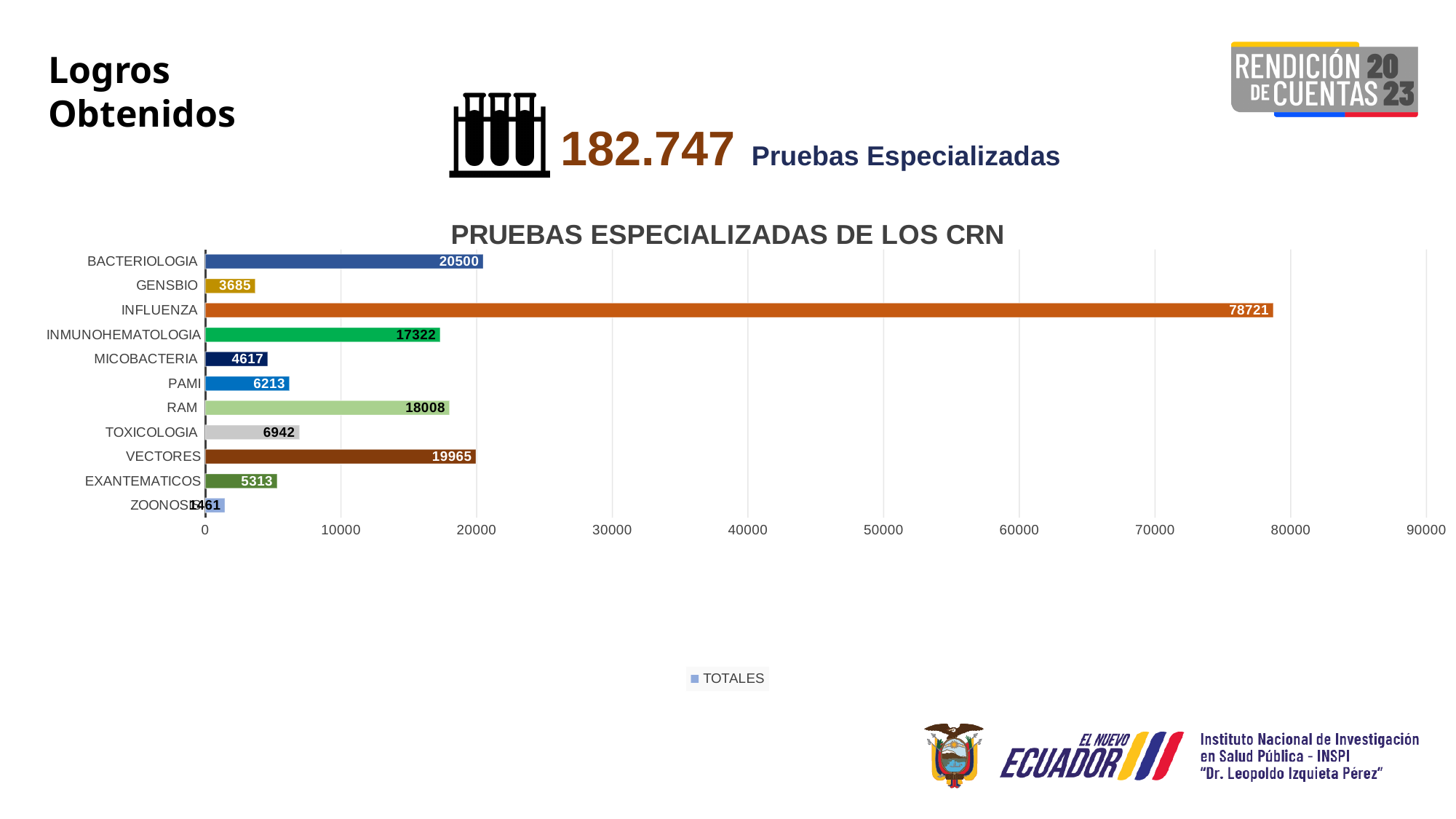
What is the difference between the values for BACTERIOLOGIA and VECTORES? 535 Which is larger, the value for PAMI or the value for MICOBACTERIA? PAMI What kind of chart is shown on the slide? bar chart What is the value for RAM in the chart? 18008 Which category has the lowest value in the chart? ZOONOSIS What is the title of the chart? PRUEBAS ESPECIALIZADAS DE LOS CRN What is the value for BACTERIOLOGIA in the chart? 20500 What is the value for INFLUENZA in the chart? 78721 How many categories are shown in the chart? 11 What is the value for TOXICOLOGIA in the chart? 6942 Which category has the highest value in the chart? INFLUENZA Is the value for INMUNOHEMATOLOGIA greater or less than 20000? less